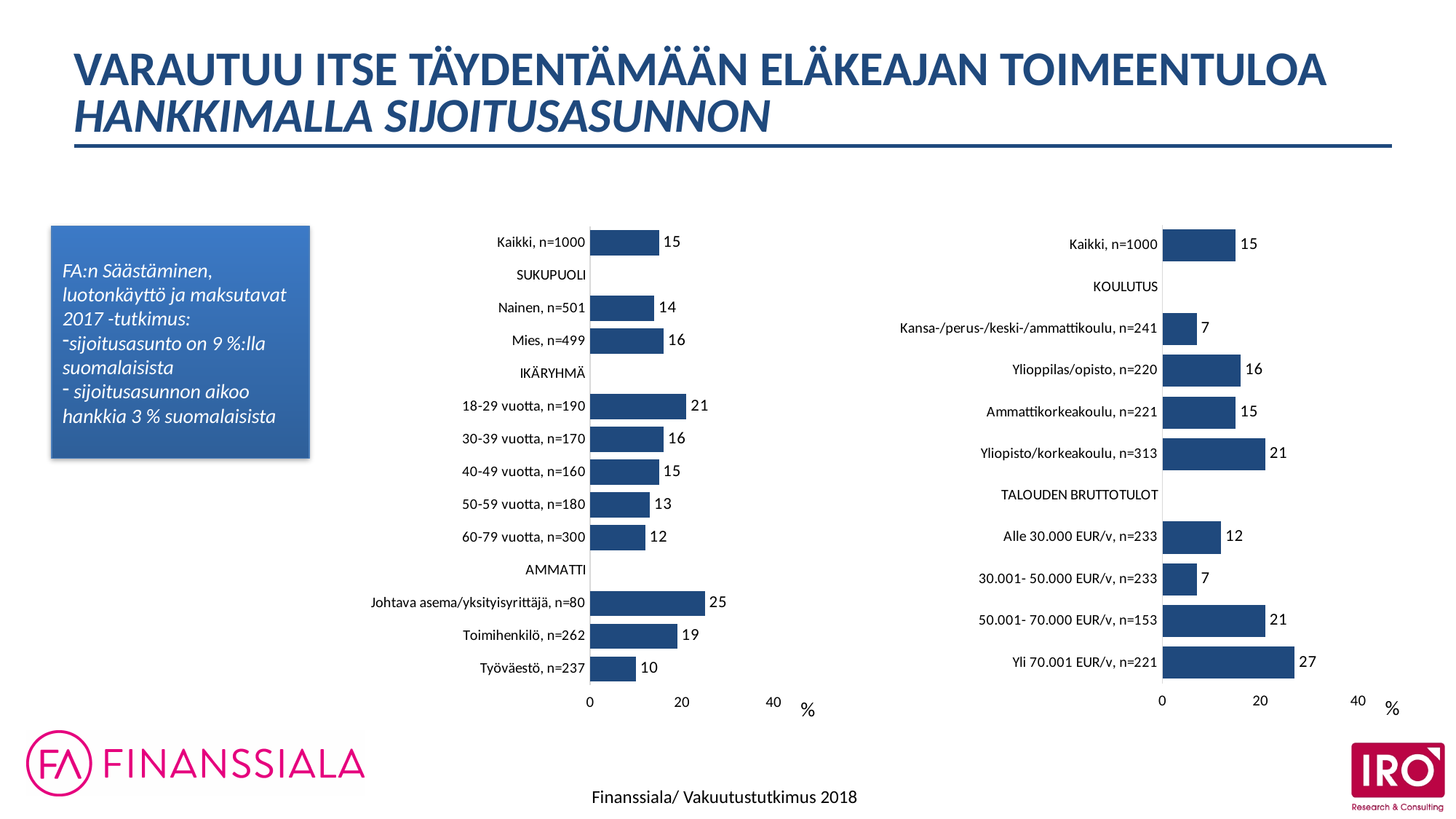
In the left chart, what is the value for 60-79 vuotta, n=300? 12 In the left chart, what is the value for Johtava asema/yksityisyrittäjä, n=80? 25 What kind of chart is the right chart? bar chart In the right chart, which is larger: the value for Ylioppilas/opisto, n=220 or Alle 30.000 EUR/v, n=233? Ylioppilas/opisto, n=220 In the right chart, what is the difference between the values for Yliopisto/korkeakoulu, n=313 and Ammattikorkeakoulu, n=221? 6 In the left chart, which category has the highest value? Johtava asema/yksityisyrittäjä, n=80 In the left chart, which category has the lowest value? Työväestö, n=237 In the left chart, do the values rise or fall across the age groups from 18-29 vuotta to 60-79 vuotta? fall In the right chart, what is the value for Yli 70.001 EUR/v, n=221? 27 In the right chart, what is the value for Kansa-/perus-/keski-/ammattikoulu, n=241? 7 In the left chart, what is the difference between the values for Mies, n=499 and Nainen, n=501? 2 In the right chart, which category has the highest value? Yli 70.001 EUR/v, n=221